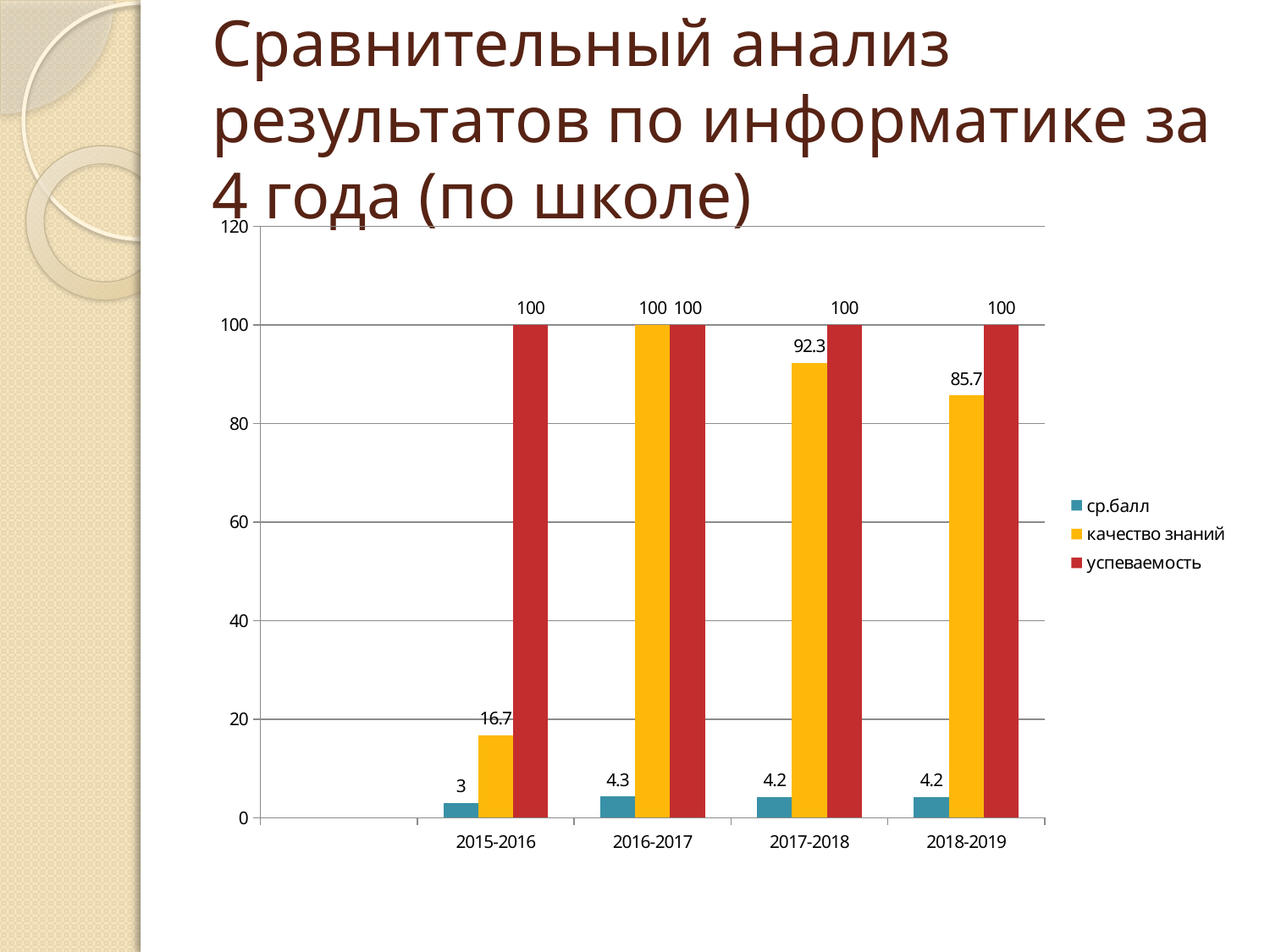
Is the value of качество знаний for 2017-2018 greater or less than 80? greater What is the difference between качество знаний in 2017-2018 and in 2018-2019? 6.6 What is the value of ср.балл for 2016-2017? 4.3 What is the value of успеваемость for 2017-2018? 100 In which year is качество знаний highest? 2016-2017 What is the value of качество знаний for 2018-2019? 85.7 Which is larger: ср.балл in 2015-2016 or ср.балл in 2016-2017? 2016-2017 How many years (categories) are shown on the x axis? 4 In which year is качество знаний lowest? 2015-2016 What is the value of качество знаний for 2015-2016? 16.7 How many series does the legend list? 3 What kind of chart is shown on the slide? bar chart